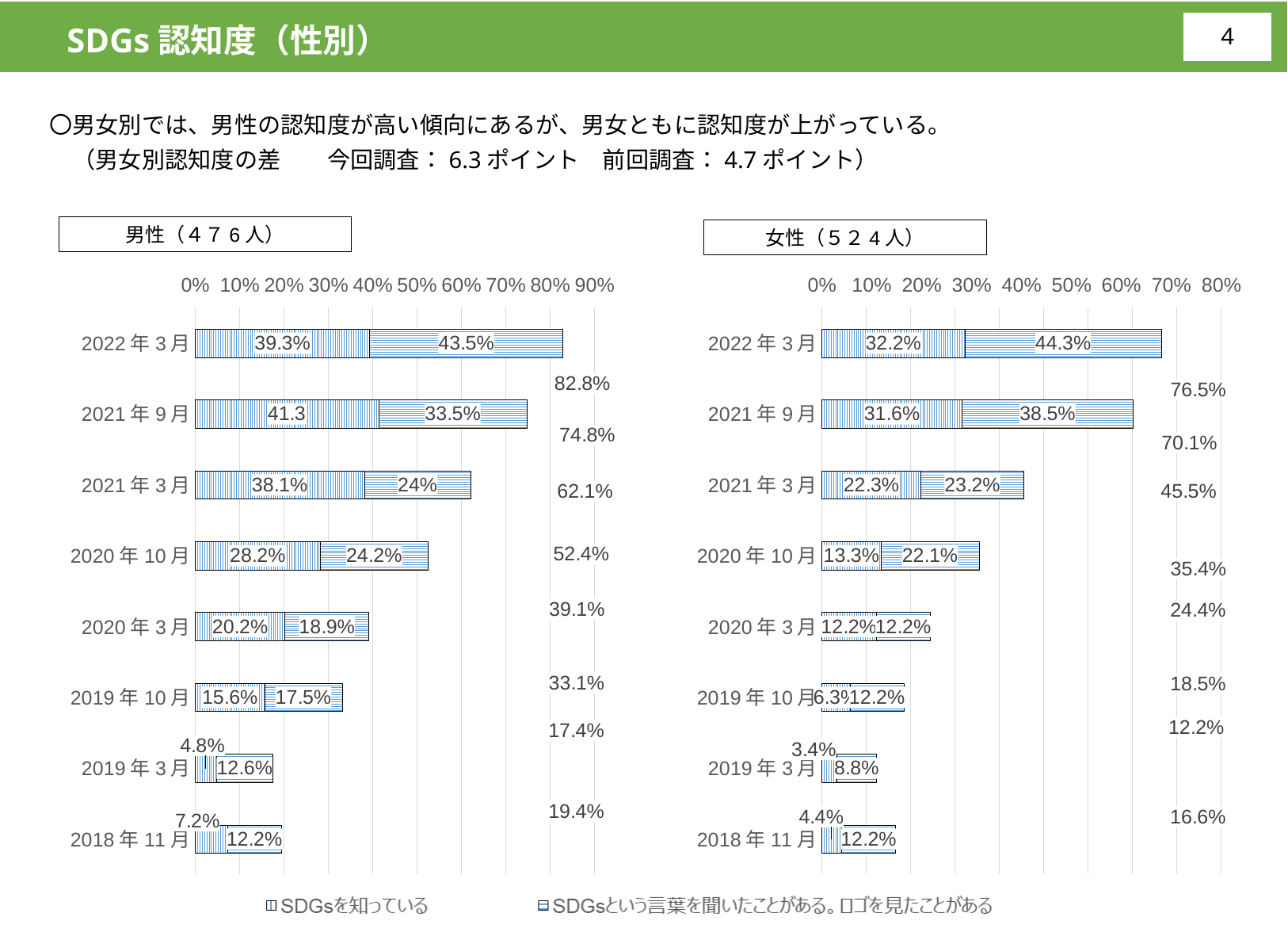
In the 女性（５２４人） chart, does the total awareness rise or fall from 2020年3月 to 2022年3月? Rise In the 男性（４７６人） chart, which time period has the highest value for SDGsを知っている? 2021年9月 In the 男性（４７６人） chart, what is the total of the stacked bar for 2021年3月? 62.1% How many series does the legend list? 2 In the 女性（５２４人） chart, what is the value of SDGsという言葉を聞いたことがある。ロゴを見たことがある for 2021年9月? 38.5% In the 男性（４７６人） chart, what is the difference between the SDGsを知っている values for 2022年3月 and 2020年3月? 19.1 percentage points What type of chart is the 男性（４７６人） chart? Stacked bar chart How many time periods are shown in the 女性（５２４人） chart? 8 In the 女性（５２４人） chart, which time period has the lowest value for SDGsを知っている? 2019年3月 In the 男性（４７６人） chart, what is the value of SDGsを知っている for 2022年3月? 39.3% Which is larger: the SDGsを知っている value for 2022年3月 in the 男性（４７６人） chart or in the 女性（５２４人） chart? 男性（４７６人） In the 女性（５２４人） chart, what is the total of the stacked bar for 2020年10月? 35.4%